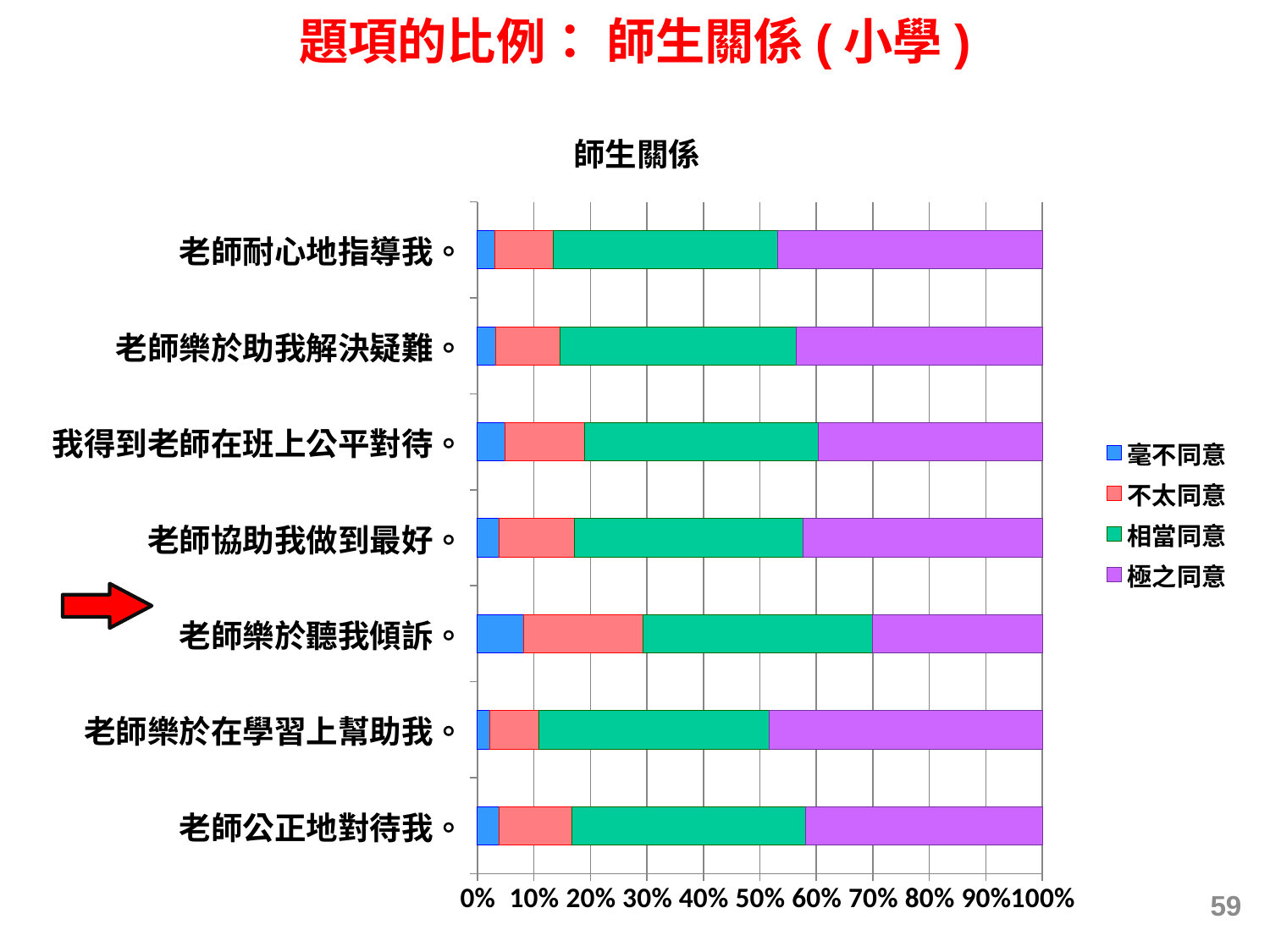
Is the 毫不同意 value for 老師樂於聽我傾訴 greater or less than 10%? less What is the title of the chart? 師生關係 Which statement has the largest 不太同意 segment? 老師樂於聽我傾訴。 Is the 極之同意 value for 老師耐心地指導我 greater or less than 40%? greater How many statements (categories) are plotted in the chart? 7 Which has the larger 毫不同意 segment: 老師樂於聽我傾訴 or 老師樂於在學習上幫助我? 老師樂於聽我傾訴 Is the 毫不同意 value for 老師樂於在學習上幫助我 greater or less than 10%? less How many series does the legend list? 4 Which statement has the smallest 極之同意 segment? 老師樂於聽我傾訴。 Which statement has the largest 毫不同意 segment? 老師樂於聽我傾訴。 What kind of chart is shown on the slide? Stacked bar chart Which statement does the red arrow on the left point to? 老師樂於聽我傾訴。